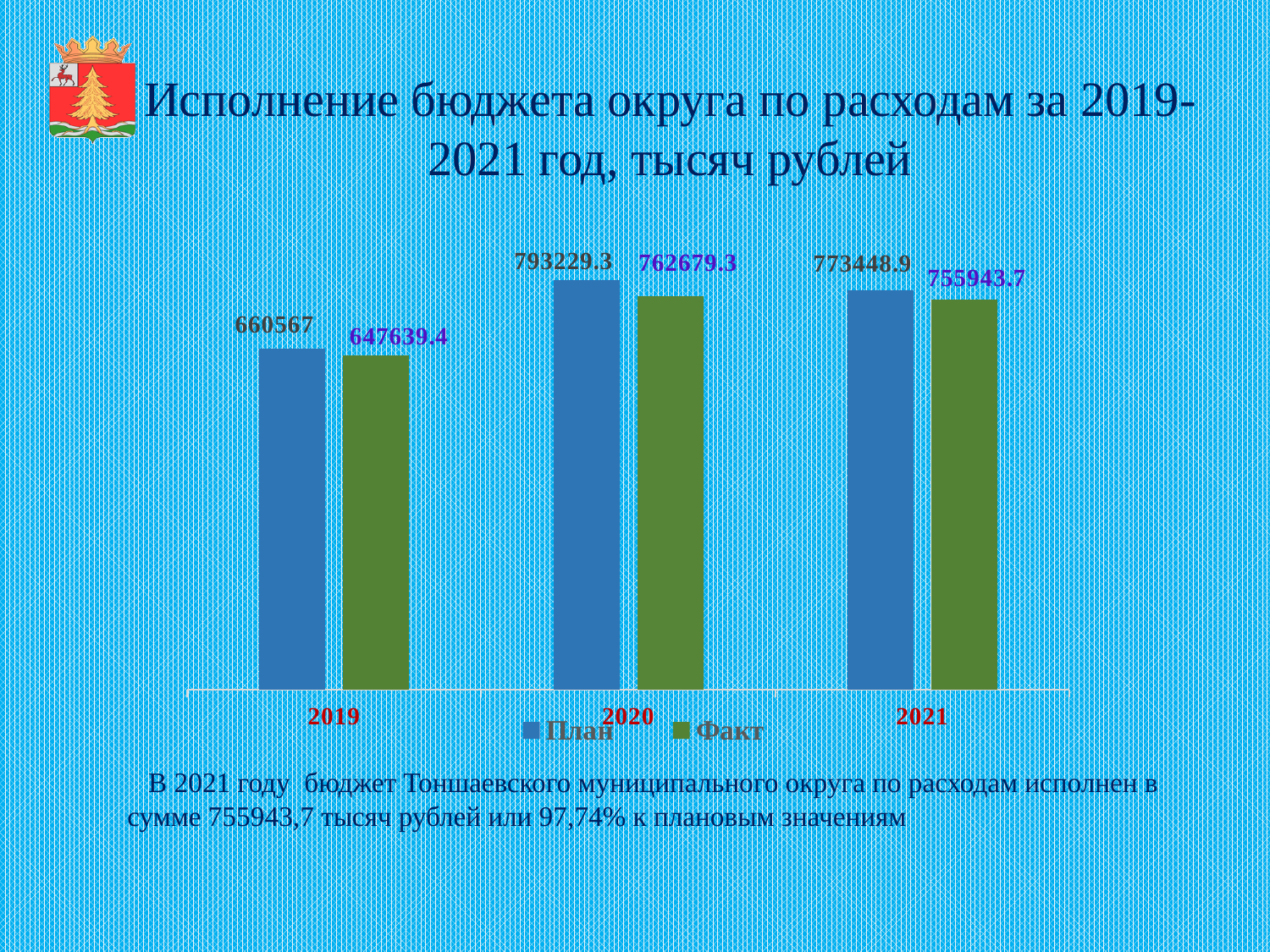
What is the Факт value for 2021? 755943.7 What is the План value for 2020? 793229.3 What kind of chart is shown on the slide? Bar chart What is the difference between the План and Факт values for 2019? 12927.6 How many series does the legend list? 2 What is the difference between the План and Факт values for 2020? 30550 In which year is the План value the lowest? 2019 What is the Факт value for 2019? 647639.4 In which year is the Факт value the highest? 2020 How many years are shown on the x axis of the chart? 3 Which is larger, the План value for 2020 or the План value for 2021? План for 2020 What is the План value for 2019? 660567